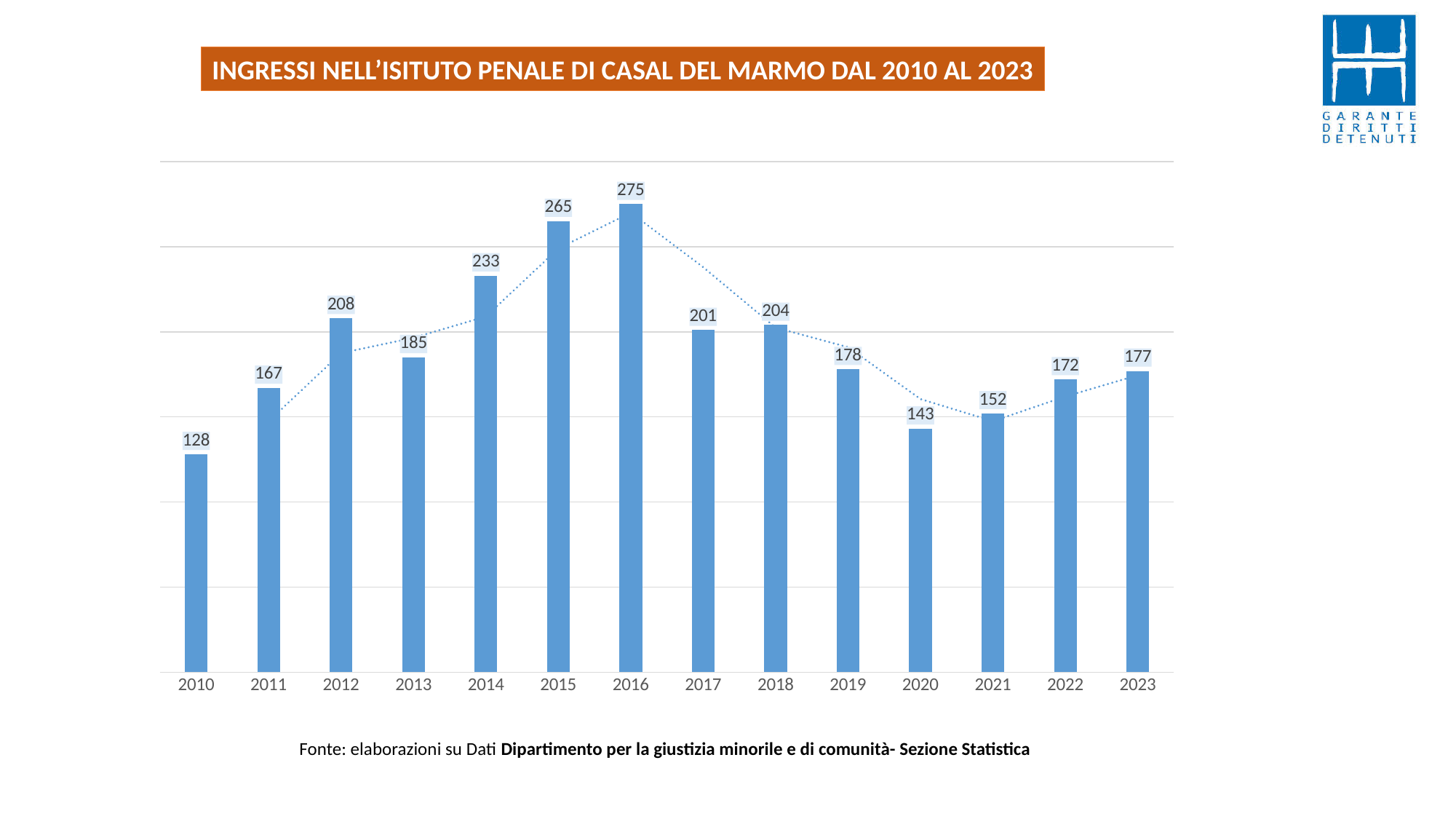
What is the value for 2016? 275 How many years are shown on the x axis? 14 Which is larger, the value for 2012 or the value for 2018? 2012 What is the difference between the values for 2015 and 2014? 32 What is the value for 2010? 128 What kind of chart is this? bar chart Which year has the lowest value? 2010 Which year has the highest value? 2016 What is the difference between the values for 2016 and 2010? 147 What is the value for 2020? 143 What is the title of the chart? INGRESSI NELL'ISITUTO PENALE DI CASAL DEL MARMO DAL 2010 AL 2023 Do the values rise or fall from 2016 to 2020? fall